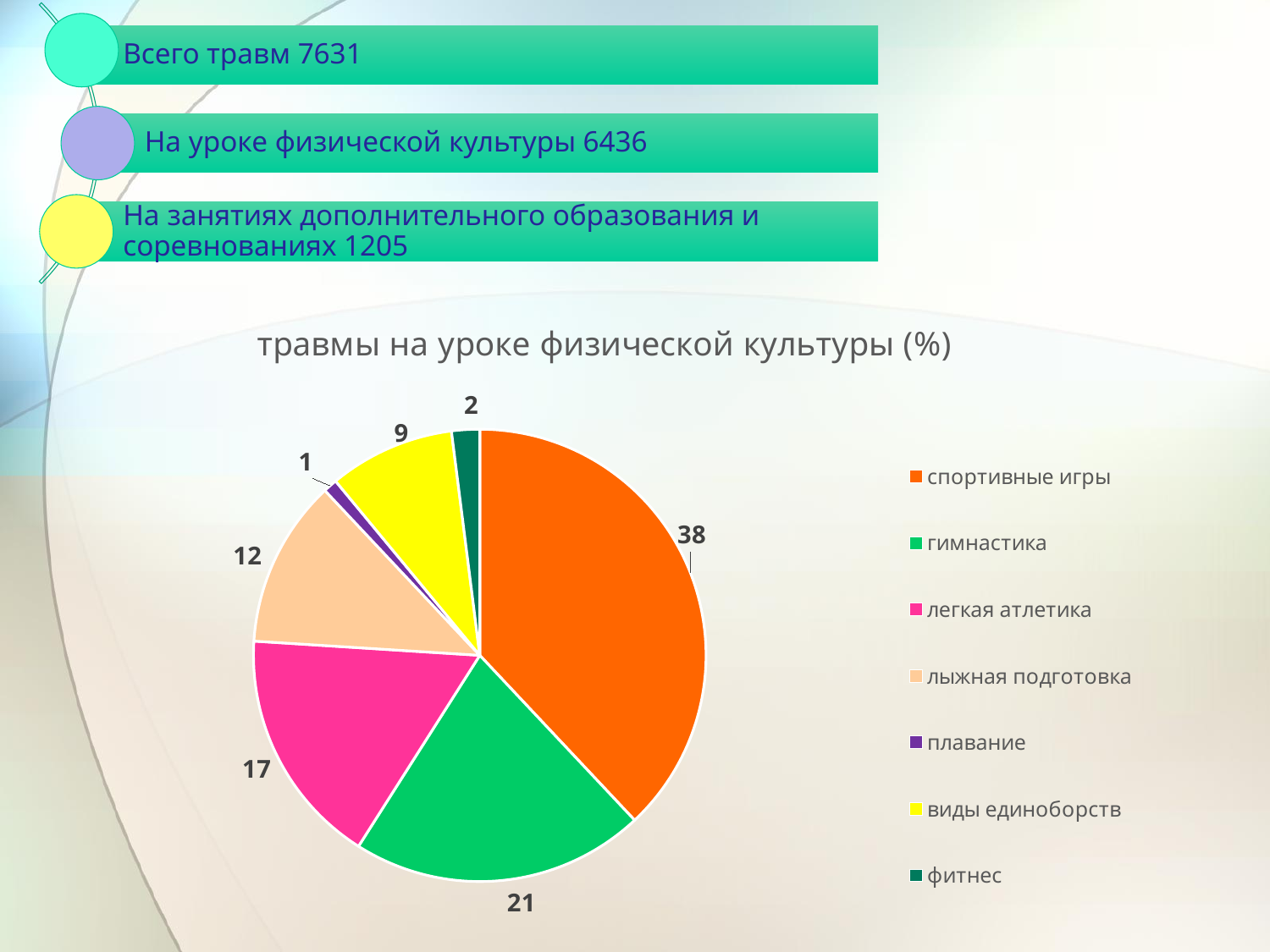
What type of chart is shown on the slide? pie chart Which category has the largest slice of the pie? спортивные игры What is the title of the chart? травмы на уроке физической культуры (%) How many categories does the pie chart have? 7 What is the difference between the values for спортивные игры and гимнастика? 17 What is the value for плавание? 1 What is the value for спортивные игры? 38 Which colour represents фитнес in the legend? dark green What is the value for лыжная подготовка? 12 Which is larger, the value for легкая атлетика or the value for виды единоборств? легкая атлетика Which category has the smallest slice of the pie? плавание What is the value for гимнастика? 21